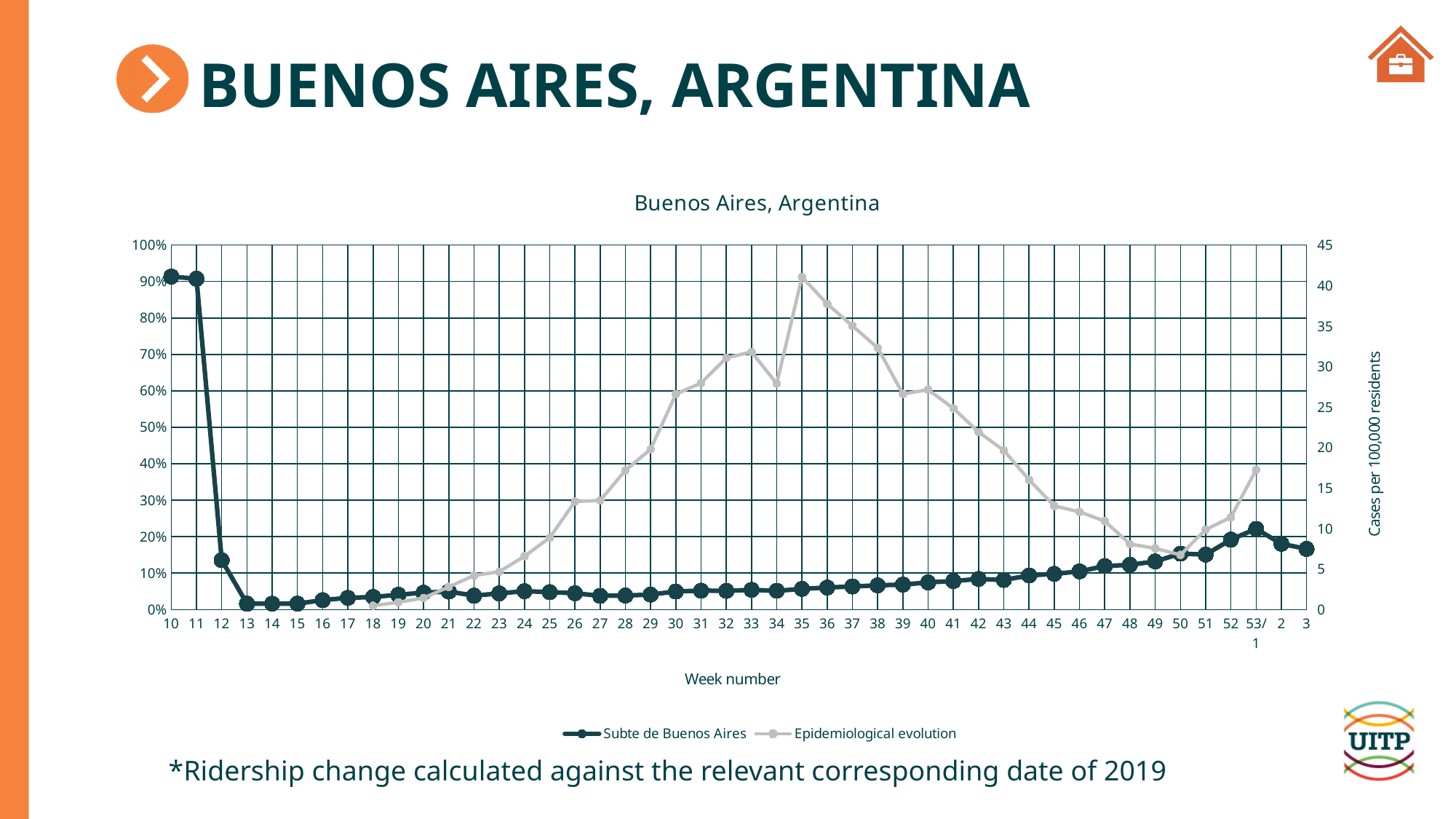
What is the title of the horizontal axis? Week number Is the Epidemiological evolution value at week 35 greater or less than 40? greater Which is larger for Subte de Buenos Aires: the value at week 10 or the value at week 12? Week 10 What kind of chart is shown on the slide? Line chart Which is larger for Epidemiological evolution: the value at week 35 or the value at week 40? Week 35 How many series does the legend list? 2 Is the Subte de Buenos Aires value at week 30 greater or less than 10%? less Does the Epidemiological evolution series rise or fall between week 35 and week 48? Fall Is the Subte de Buenos Aires value at week 12 greater or less than 10%? greater At which week number does the Epidemiological evolution series reach its highest value? 35 What is the title of the right-hand vertical axis? Cases per 100,000 residents